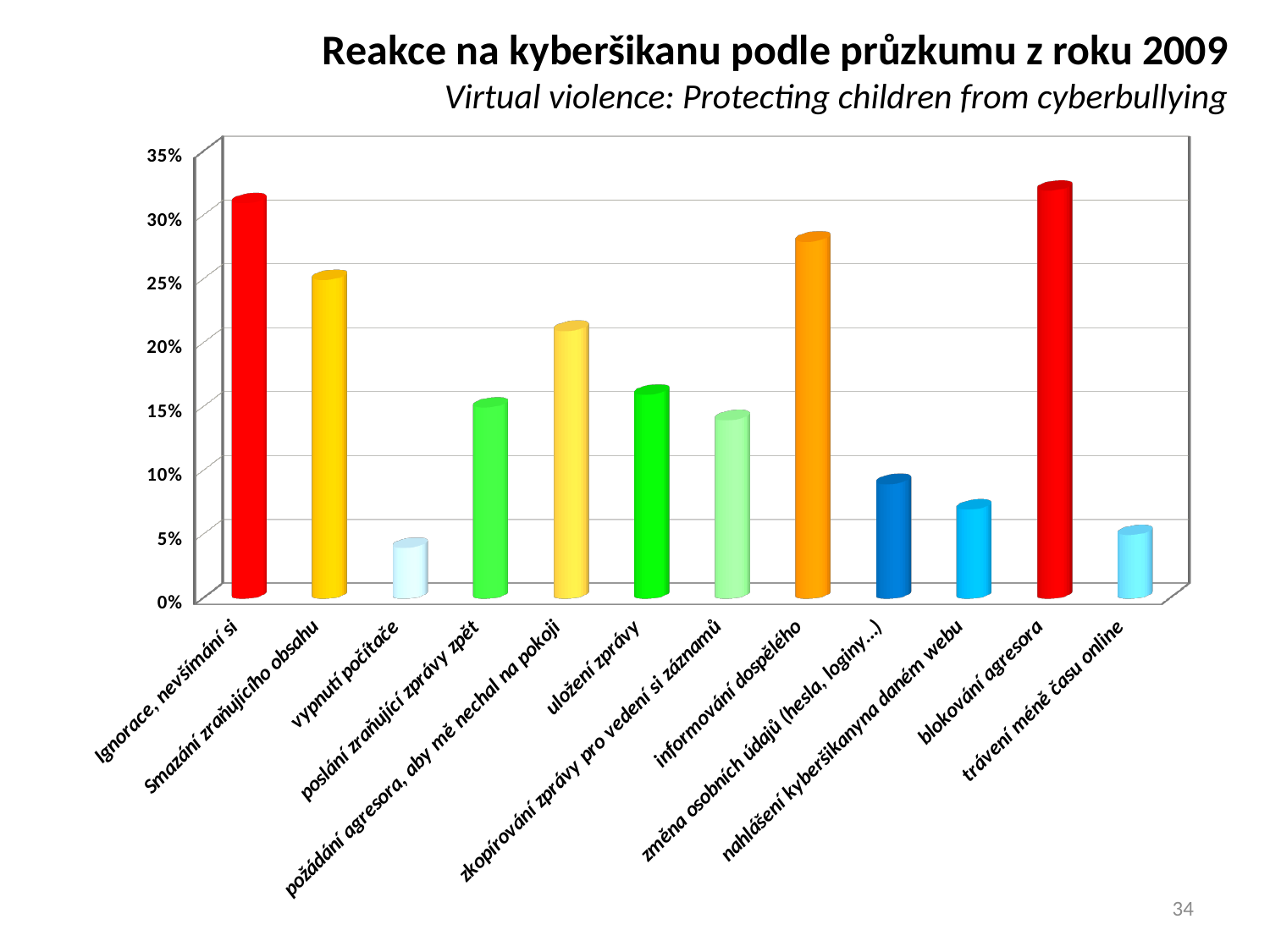
How many categories (reactions) are shown on the x axis of the chart? 12 Which is larger: the value for 'Ignorace, nevšímání si' or the value for 'zkopírování zprávy pro vedení si záznamů'? Ignorace, nevšímání si Is the value for 'nahlášení kyberšikany na daném webu' greater or less than 10%? less Which is larger: the value for 'informování dospělého' or the value for 'Smazání zraňujícího obsahu'? informování dospělého What is the highest value shown on the vertical axis of the chart? 35% What kind of chart is shown on the slide? bar chart Which is larger: the value for 'blokování agresora' or the value for 'trávení méně času online'? blokování agresora Is the value for 'informování dospělého' greater or less than 25%? greater Is the value for 'blokování agresora' greater or less than 30%? greater What is the title of the chart on the slide? Reakce na kyberšikanu podle průzkumu z roku 2009